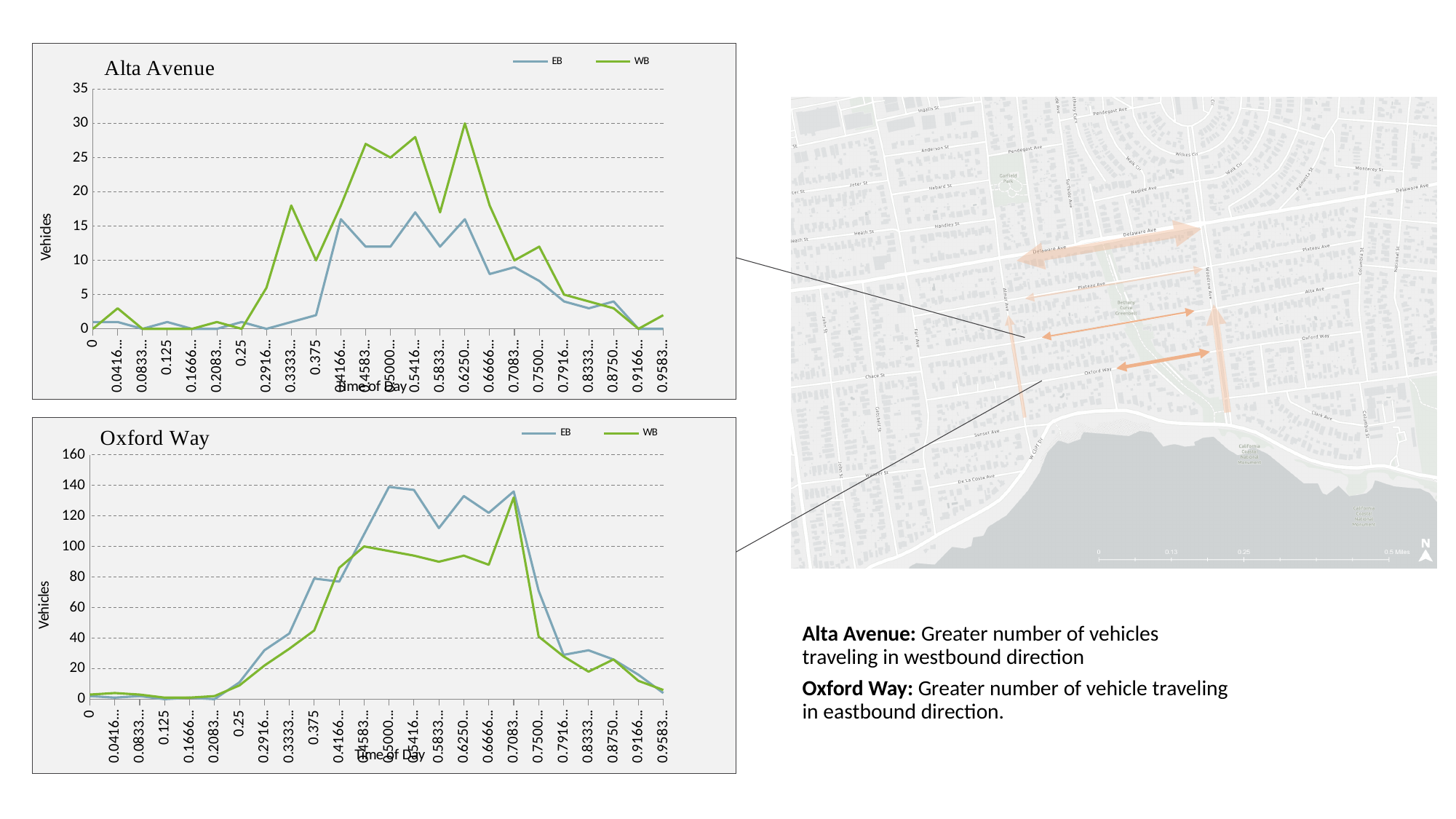
How many time-of-day points are plotted along the x axis of the Oxford Way chart? 24 What kind of chart is the Alta Avenue chart? line chart How many series does the legend of the Oxford Way chart list? 2 In the Oxford Way chart, is the EB value at 0.375 greater or less than 60? greater In the Alta Avenue chart, at 0.625 which series has the larger value, EB or WB? WB In the Oxford Way chart, which series reaches the highest value? EB In the Alta Avenue chart, is the WB value at 0.625 greater or less than 25? greater What is the y-axis title of the Oxford Way chart? Vehicles What are the two series named in the legend of the Alta Avenue chart? EB and WB In the Alta Avenue chart, is the EB value at 0.375 greater or less than 5? less In the Oxford Way chart, at 0.5 which series has the larger value, EB or WB? EB In the Alta Avenue chart, which series reaches the highest value? WB